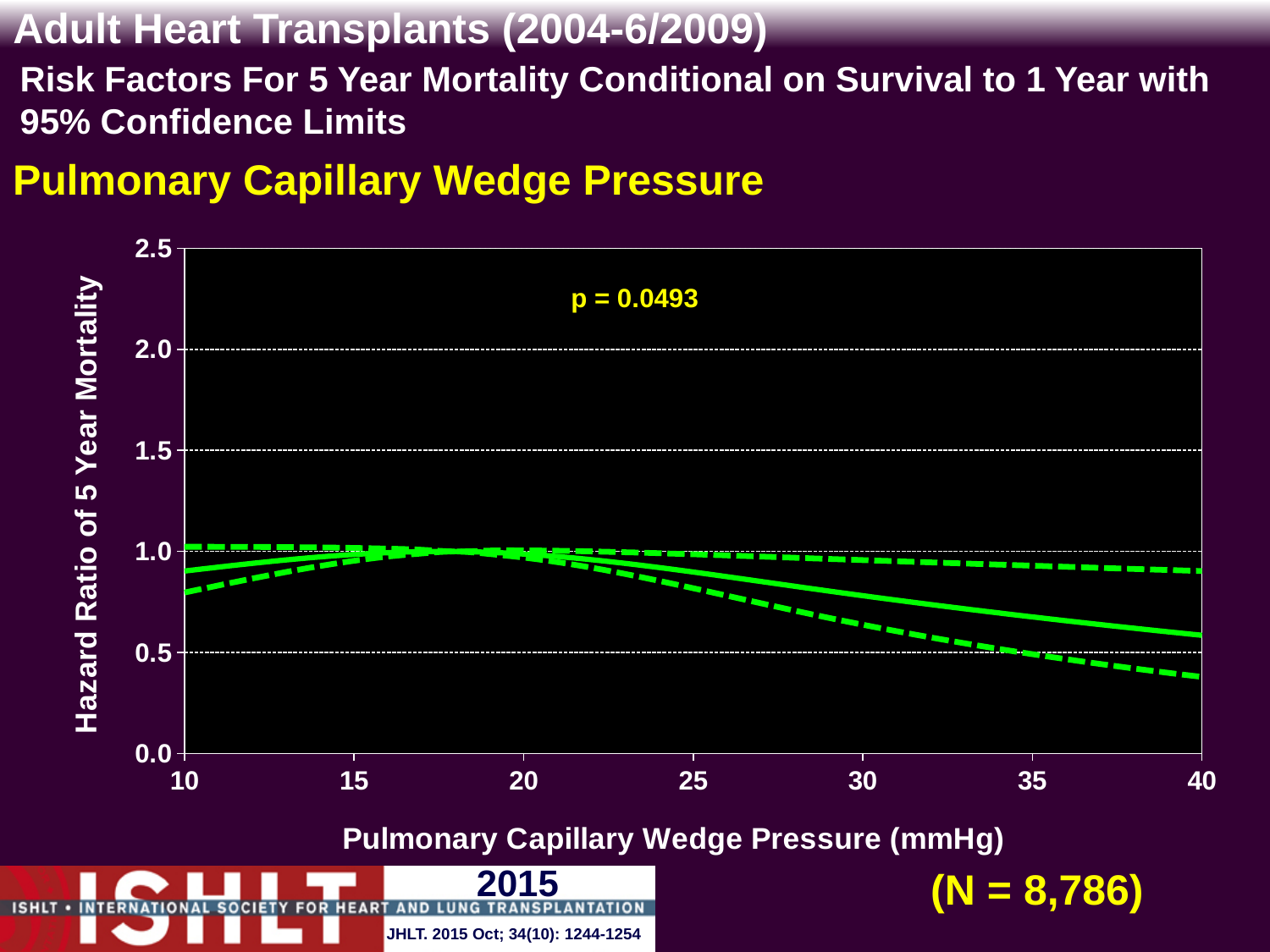
Does the solid hazard ratio line rise or fall as pulmonary capillary wedge pressure increases from 20 to 40 mmHg? fall Is the solid hazard ratio line at 30 mmHg greater or less than 0.5? greater Is the lower dashed confidence limit at 40 mmHg greater or less than 0.5? less Is the solid hazard ratio line at 10 mmHg greater or less than 1.5? less What p-value is printed on the chart? p = 0.0493 What is the highest value shown on the y axis? 2.5 What is the sample size (N) shown on the slide? N = 8,786 What kind of chart is shown on the slide? line chart How many lines are plotted on the chart? 3 Is the solid hazard ratio line higher at 20 mmHg or at 40 mmHg? 20 mmHg